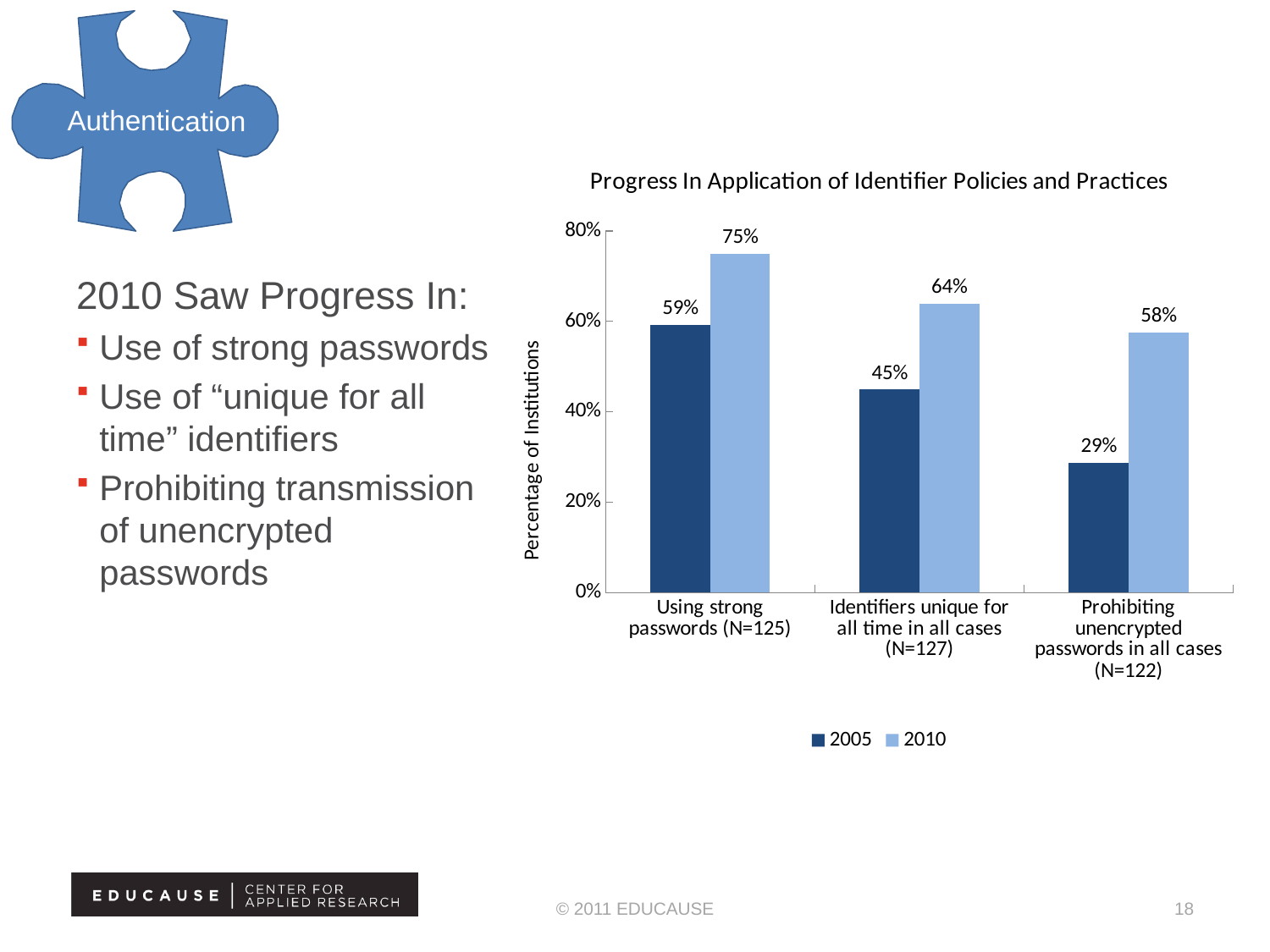
What is the 2010 value for Using strong passwords (N=125)? 75% How many categories are shown on the x axis? 3 How many series does the legend list? 2 What is the 2005 value for Prohibiting unencrypted passwords in all cases (N=122)? 29% What is the difference between the 2010 and 2005 values for Identifiers unique for all time in all cases (N=127)? 19% Which category has the highest 2010 value? Using strong passwords (N=125) What is the difference between the 2010 and 2005 values for Prohibiting unencrypted passwords in all cases (N=122)? 29% What kind of chart is shown? Bar chart Which is larger: the 2005 value for Using strong passwords or the 2010 value for Prohibiting unencrypted passwords? 2005 value for Using strong passwords What is the 2005 value for Identifiers unique for all time in all cases (N=127)? 45% Which category has the lowest 2005 value? Prohibiting unencrypted passwords in all cases (N=122) What is the title of the chart? Progress In Application of Identifier Policies and Practices